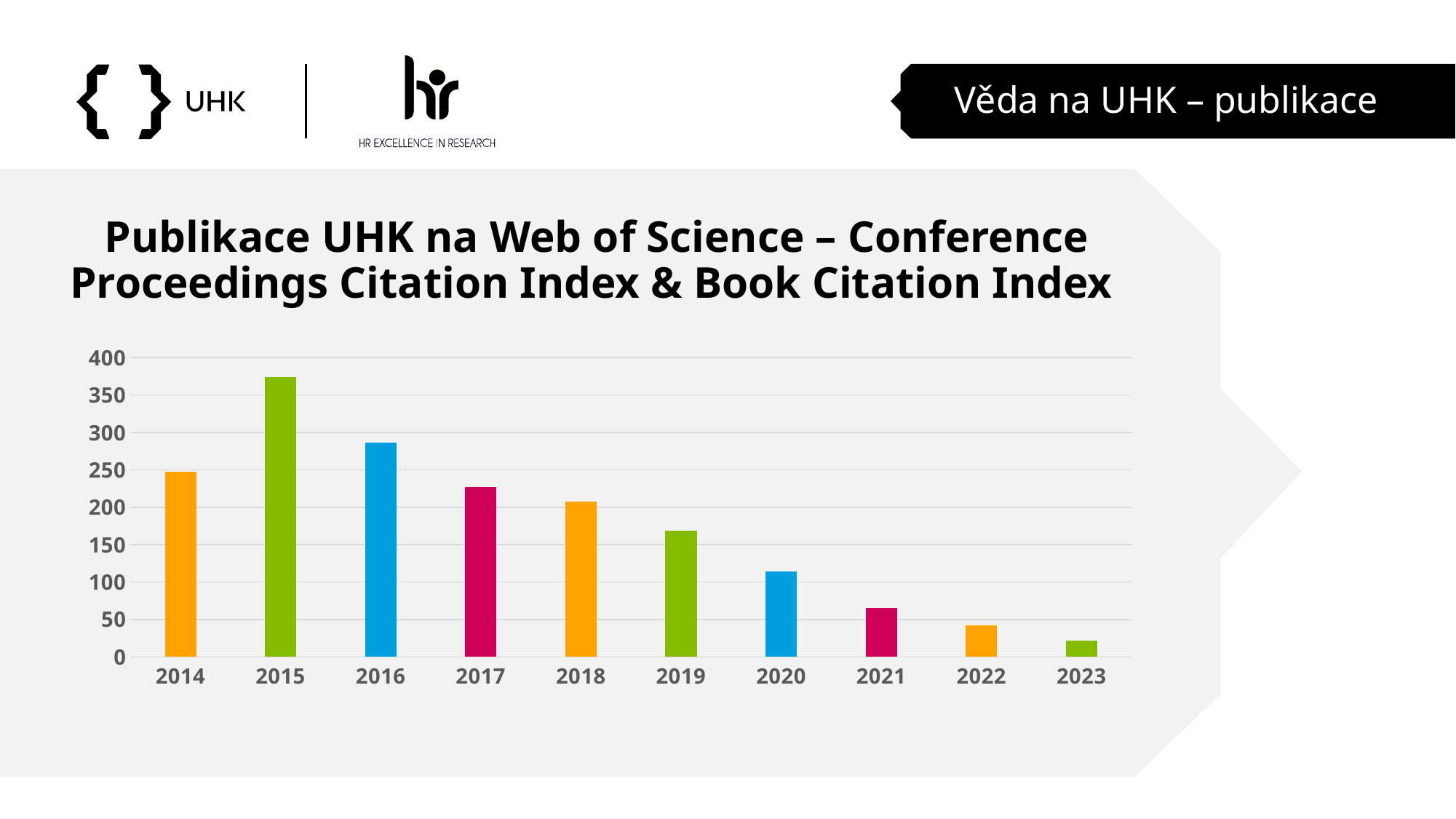
Which year has the highest number of publications in the chart? 2015 Is the value for 2018 greater or less than 200? greater Do the values generally rise or fall from 2015 to 2023? fall Is the value for 2016 greater or less than 300? less Which is larger, the value for 2014 or the value for 2017? 2014 What is the title of the chart? Publikace UHK na Web of Science – Conference Proceedings Citation Index & Book Citation Index What kind of chart is shown on the slide? bar chart Is the value for 2015 greater or less than 350? greater Which year has the lowest number of publications in the chart? 2023 How many years are shown on the x axis of the chart? 10